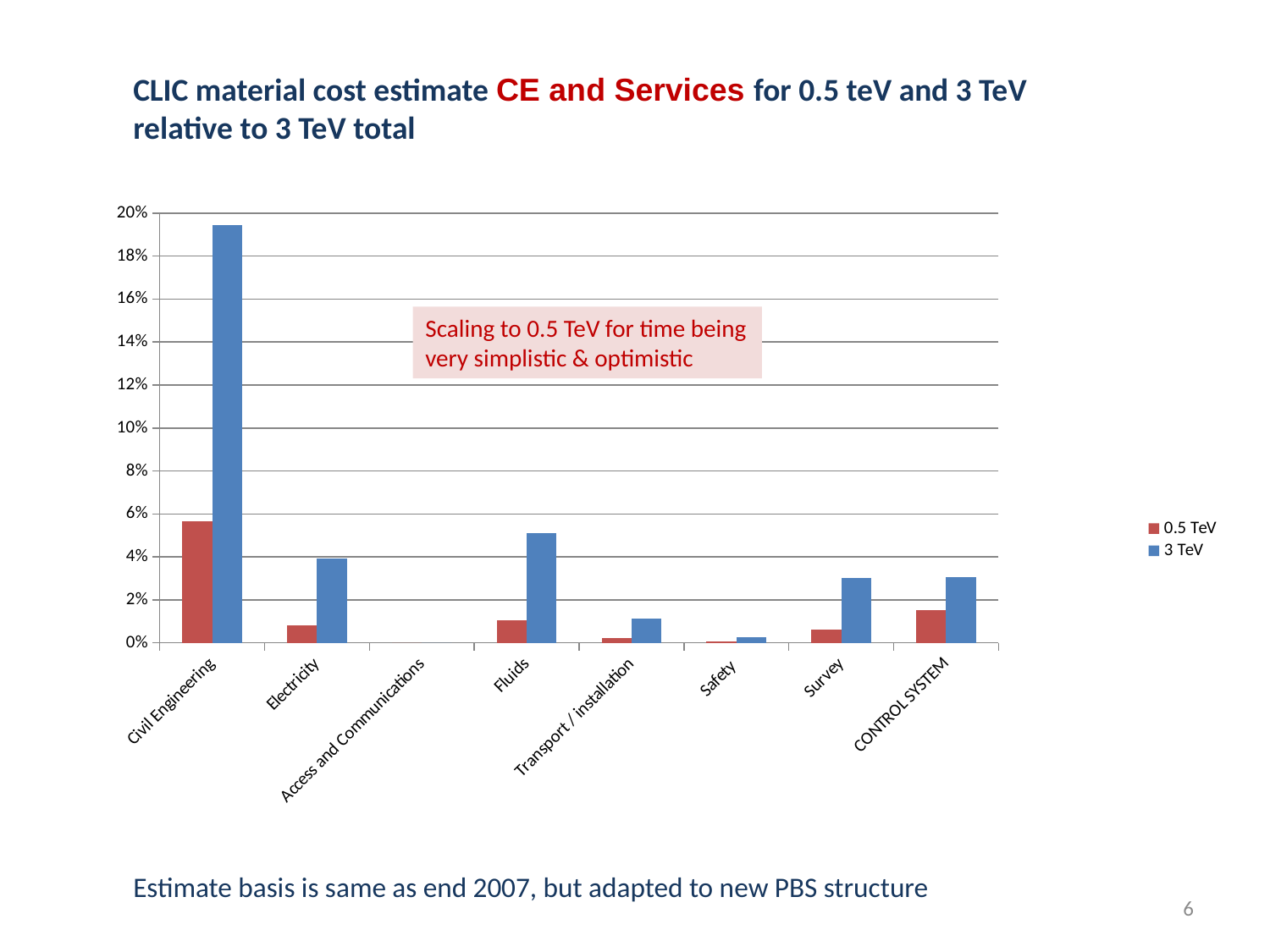
Is the 3 TeV value for Fluids greater or less than 4%? greater Is the 3 TeV value for Transport / installation greater or less than 2%? less How many categories are shown on the x axis? 8 Which category has the highest value for the 3 TeV series? Civil Engineering Which category has the highest value for the 0.5 TeV series? Civil Engineering What are the two series named in the legend? 0.5 TeV and 3 TeV For the 3 TeV series, which is larger: Fluids or Electricity? Fluids How many series does the legend list? 2 Is the 3 TeV value for Civil Engineering greater or less than 18%? greater What kind of chart is shown on the slide? bar chart Which category has the lowest value for the 3 TeV series? Access and Communications